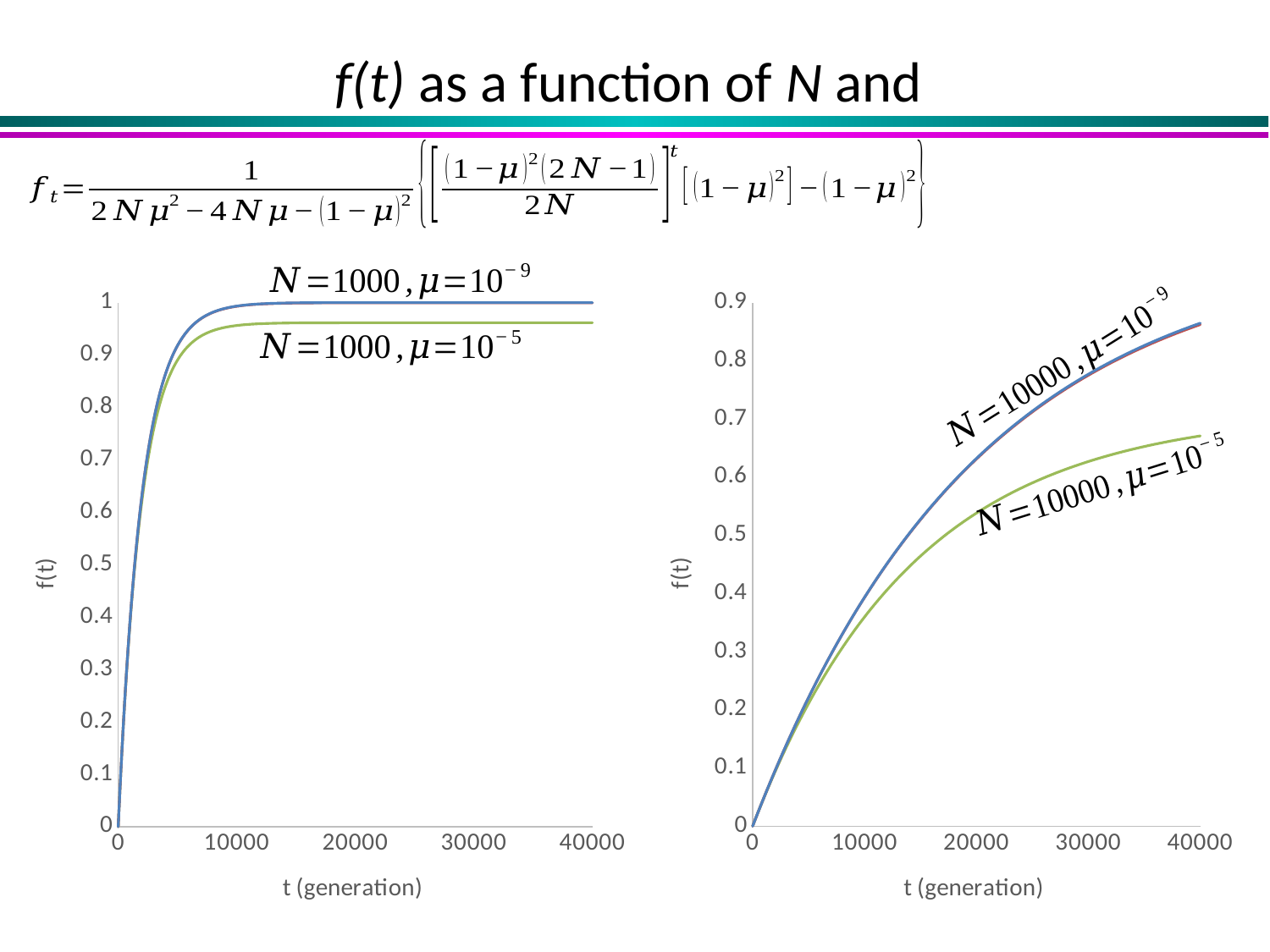
In the left chart (N = 1000), is the value of the μ = 10^-5 curve at t = 40000 greater or less than 0.9? greater What is the x-axis label of the left chart (N = 1000)? t (generation) In the right chart (N = 10000), which curve is higher at t = 40000, μ = 10^-9 or μ = 10^-5? μ = 10^-9 In the right chart (N = 10000), is the value of the μ = 10^-5 curve at t = 40000 greater or less than 0.7? less What kind of chart is the left chart (N = 1000)? line chart What kind of chart is the right chart (N = 10000)? line chart In the right chart (N = 10000), is the value of the μ = 10^-9 curve at t = 40000 greater or less than 0.8? greater In the left chart (N = 1000), which curve is higher at t = 40000, μ = 10^-9 or μ = 10^-5? μ = 10^-9 In the right chart (N = 10000), do the curves rise or fall as t increases? rise How many labelled curves are plotted in the right chart (N = 10000)? 2 In the left chart (N = 1000), do the curves rise or fall as t increases? rise